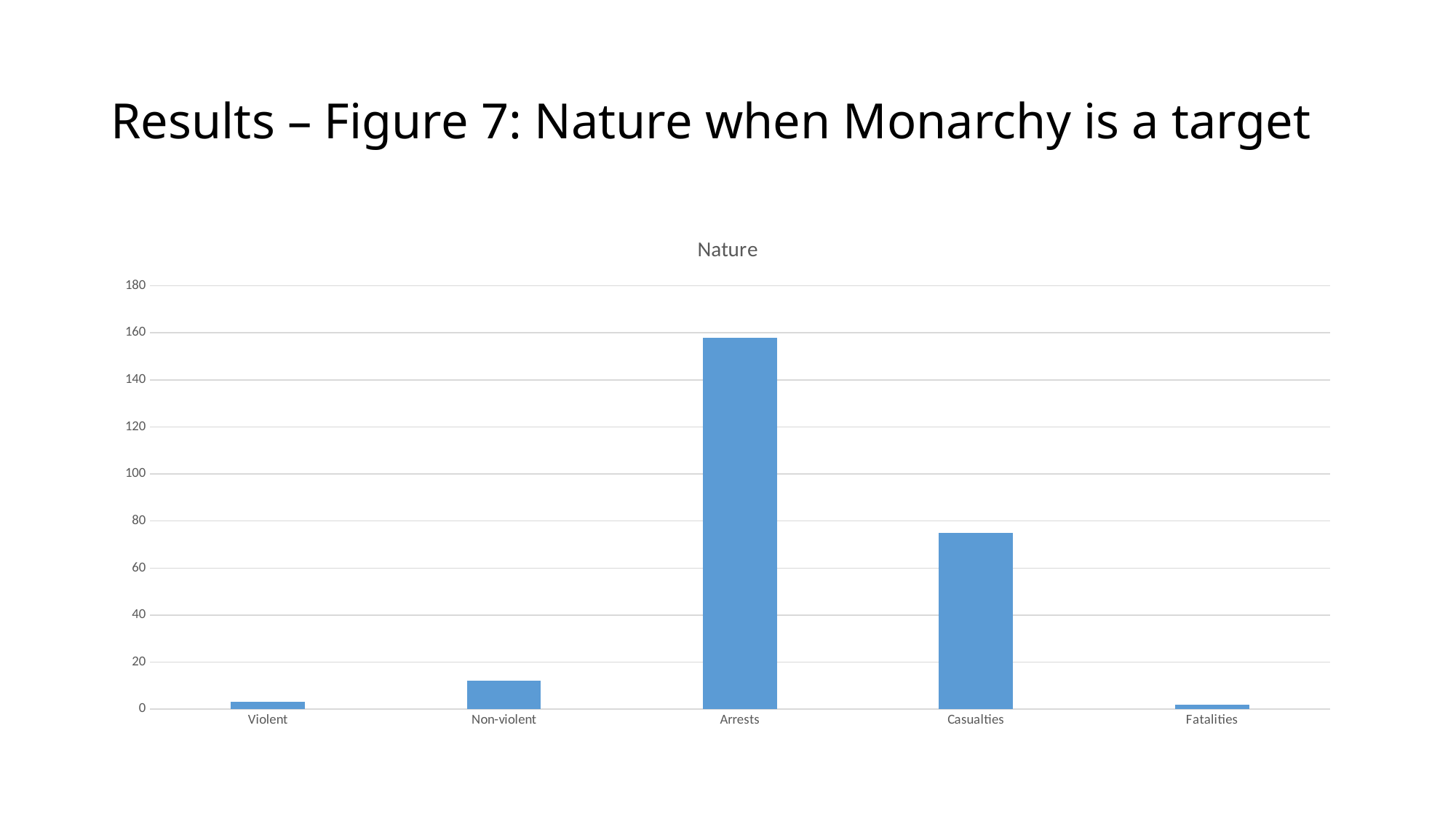
Is the value for Arrests greater or less than 140? greater Is the value for Non-violent greater or less than 20? less Is the value for Casualties greater or less than 60? greater What is the title of the chart? Nature What is the highest value shown on the y axis of the chart? 180 Which is larger, the value for Arrests or the value for Casualties? Arrests Which category has the highest value in the chart? Arrests Which is larger, the value for Casualties or the value for Non-violent? Casualties How many categories are shown on the x axis of the chart? 5 What kind of chart is shown on the slide? bar chart